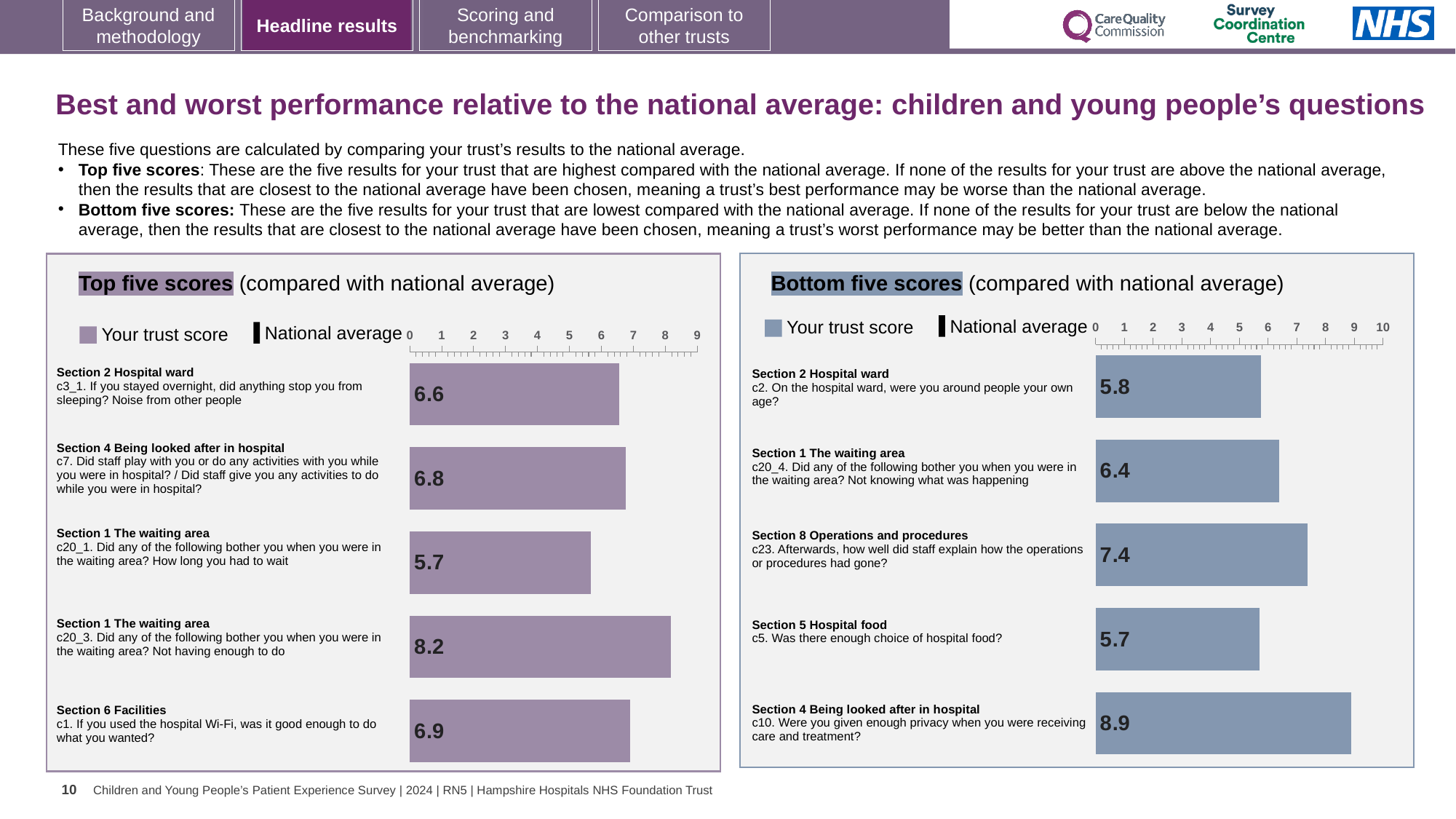
In the Bottom five scores chart, what is the trust score for c2 (being around people your own age on the ward)? 5.8 In the Top five scores chart, which question has the lowest trust score? c20_1. How long you had to wait In the Bottom five scores chart, what is the trust score for c23 (how well staff explained how operations or procedures had gone)? 7.4 In the Bottom five scores chart, which question has the lowest trust score? c5. Was there enough choice of hospital food? What type of chart is the Top five scores chart? Bar chart In the Top five scores chart, what is the trust score for c1 (hospital Wi-Fi)? 6.9 In the Top five scores chart, what is the difference between the trust scores for c20_3 and c20_1? 2.5 In the Top five scores chart, what is the trust score for c20_3 (Not having enough to do in the waiting area)? 8.2 In the Bottom five scores chart, which has the larger trust score: c20_4 or c23? c23 In the Bottom five scores chart, which question has the highest trust score? c10. Were you given enough privacy when you were receiving care and treatment? How many questions are plotted in the Bottom five scores chart? 5 In the Top five scores chart, which question has the highest trust score? c20_3. Not having enough to do in the waiting area